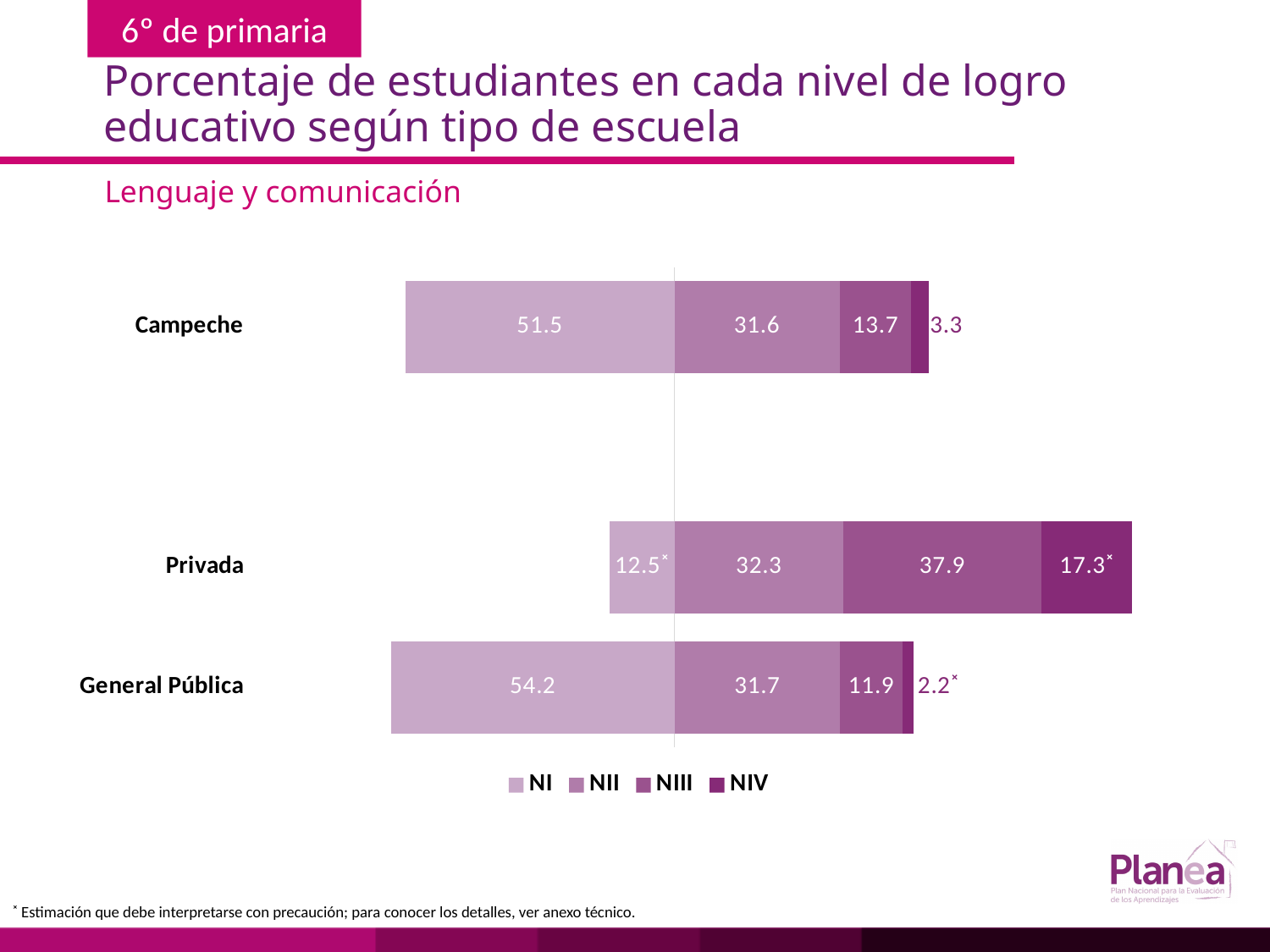
Which school type has the highest NI value? General Pública Which is larger, the NIII value for Campeche or the NIII value for General Pública? Campeche What percentage of Campeche students are at level NI? 51.5 What is the total of the stacked bar for Privada? 100.0 What is the NII value for General Pública? 31.7 What is the difference between the NI values for General Pública and Campeche? 2.7 Which school type has the lowest NIV value? General Pública What kind of chart is shown on the slide? Stacked bar chart What is the NIV value for Campeche? 3.3 How many school types (categories) are shown in the chart? 3 How many series does the legend list? 4 What is the NIII value for Privada schools? 37.9